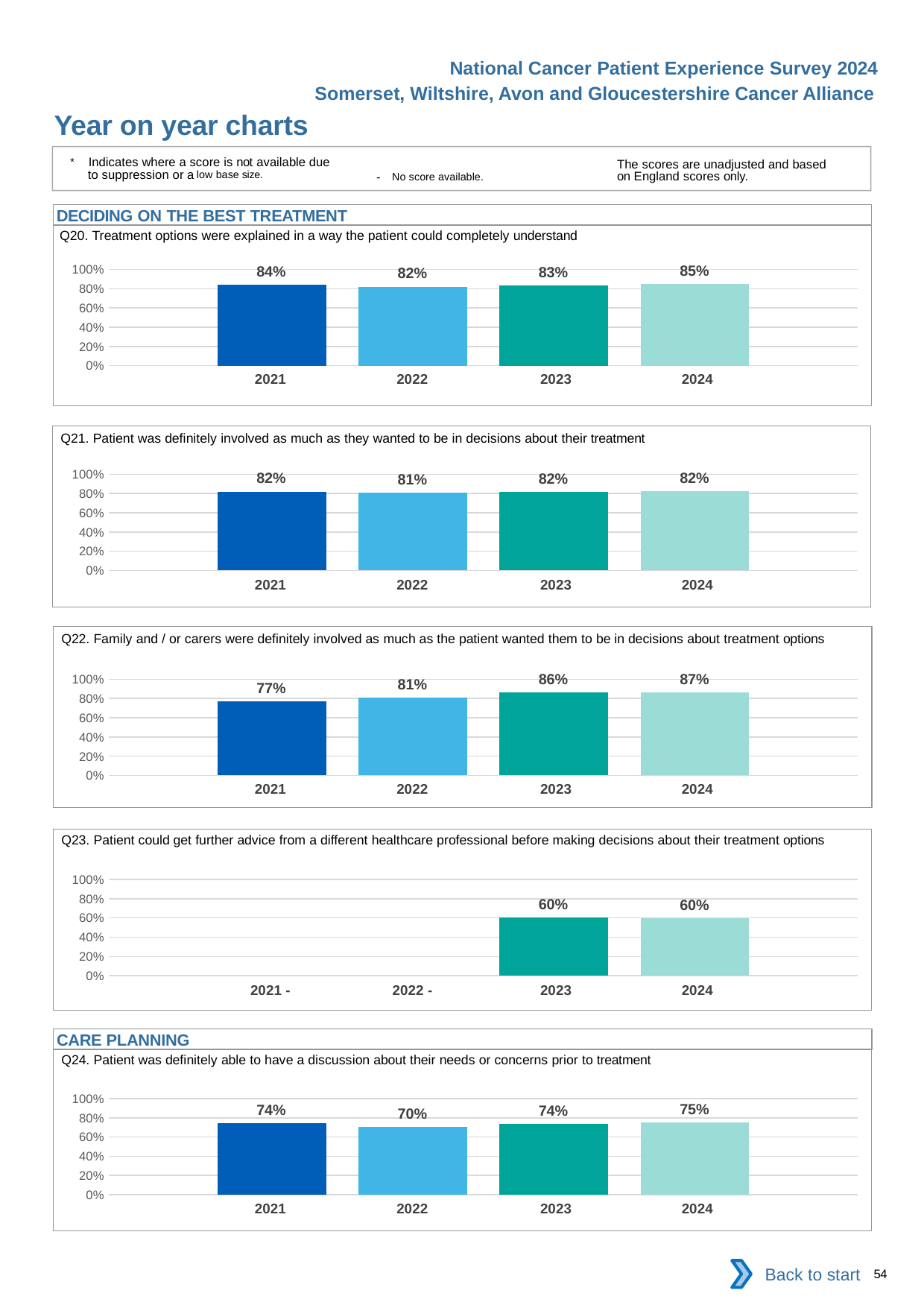
What kind of chart is used for Q20? bar chart In the Q22 chart, what is the difference between the 2024 and 2021 values? 10 percentage points In the Q23 chart, how many years have a bar plotted? 2 In the Q22 chart, do the values rise or fall from 2021 to 2024? rise In the Q21 chart, what is the value for 2022? 81% In the Q20 chart, what is the value for 2024? 85% In the Q23 chart, what is the value for 2023? 60% In the Q22 chart, which year has the highest value? 2024 In the Q20 chart, which year has the lowest value? 2022 In the Q24 chart, is the value for 2022 greater or less than 80%? less In the Q24 chart, which year has the lowest value? 2022 In the Q24 chart, which is larger, the value for 2021 or the value for 2022? 2021